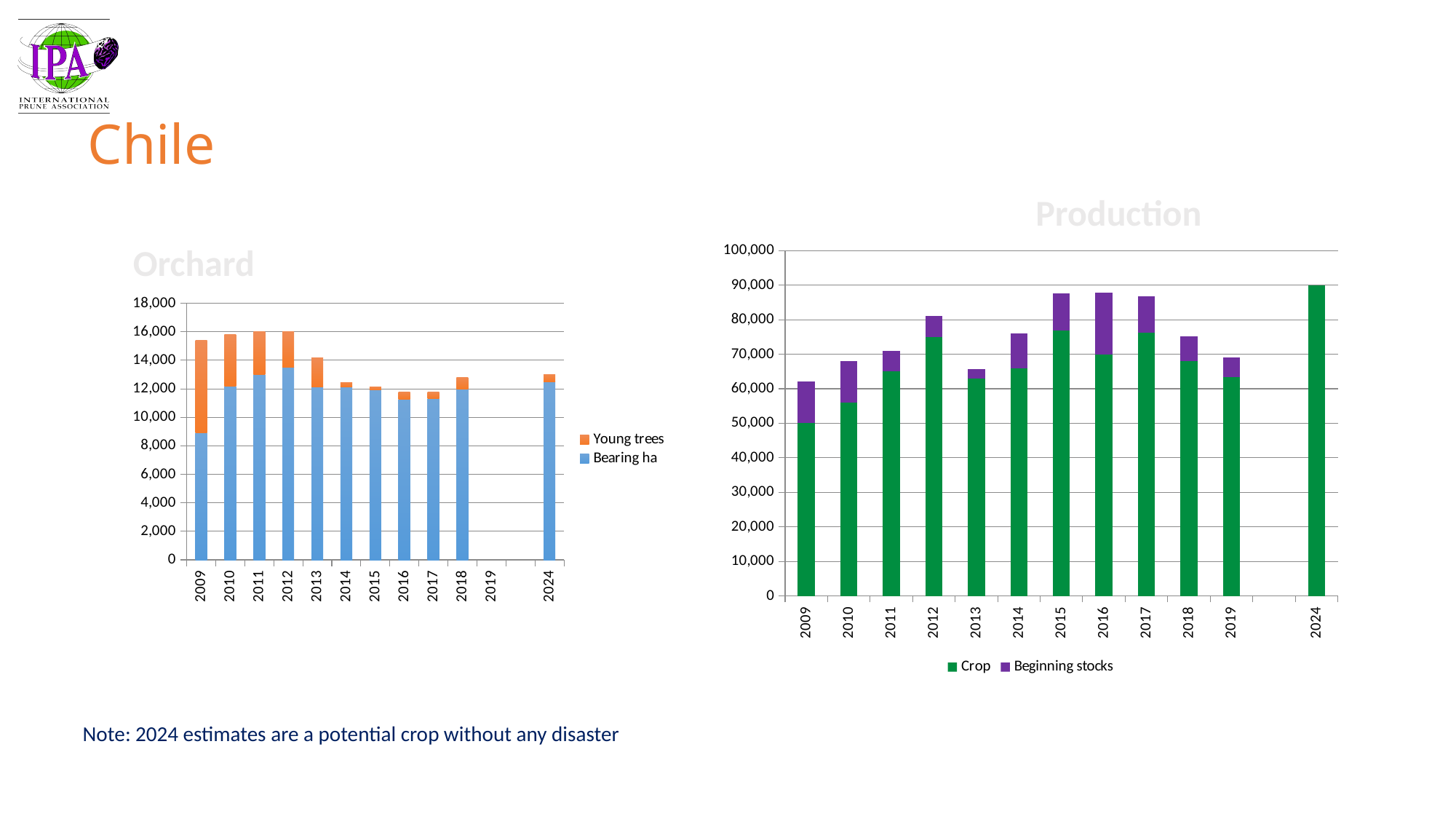
In the Production chart, is the Crop value for 2012 greater or less than 70,000? greater How many series does the legend of the Production chart list? 2 In the Production chart, which year has the larger total bar, 2012 or 2013? 2012 In the Orchard chart, which year label on the x axis has no bar plotted? 2019 In the Production chart, which year has the highest total bar? 2024 In the Orchard chart, is the Bearing ha value for 2009 greater or less than 10,000? less In the Orchard chart, is the total bar for 2024 greater or less than 14,000? less How many series does the legend of the Orchard chart list? 2 What kind of chart is the Orchard chart? bar chart In the Orchard chart, which year has the largest Young trees segment? 2009 What kind of chart is the Production chart? bar chart In the Production chart, which year has the lowest total bar? 2009